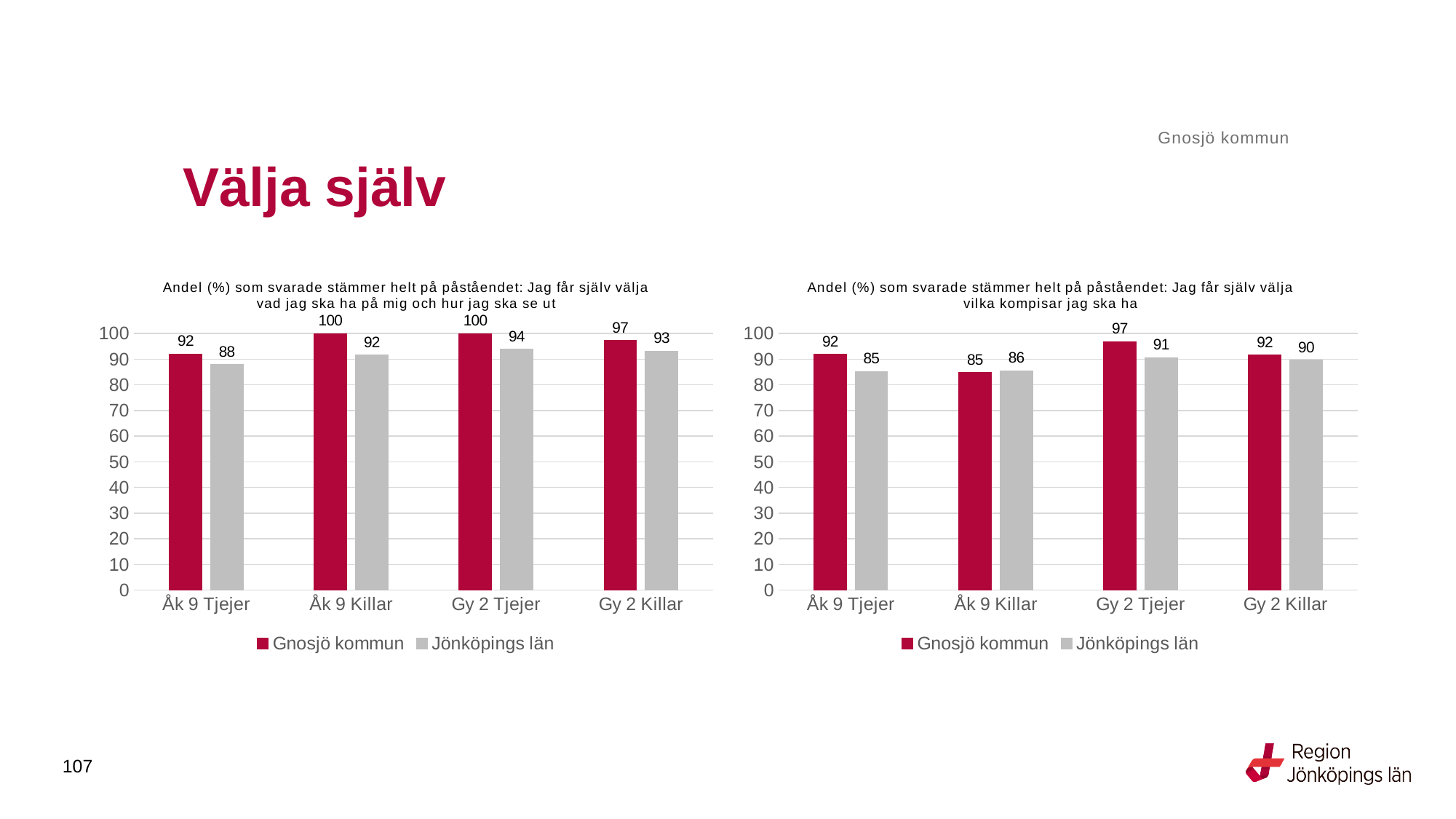
In the left chart (about choosing what to wear and how to look), what is the value for Gnosjö kommun for Åk 9 Tjejer? 92 In the left chart (about choosing what to wear and how to look), which category has the lowest value for Jönköpings län? Åk 9 Tjejer How many series does the legend of the right chart list? 2 In the right chart (about choosing which friends to have), what is the value for Gnosjö kommun for Gy 2 Tjejer? 97 In the left chart (about choosing what to wear and how to look), what is the value for Jönköpings län for Gy 2 Killar? 93 In the left chart (about choosing what to wear and how to look), what is the difference between Gnosjö kommun and Jönköpings län for Åk 9 Killar? 8 In the right chart (about choosing which friends to have), which category has the lowest value for Gnosjö kommun? Åk 9 Killar In the right chart (about choosing which friends to have), what is the difference between Gnosjö kommun and Jönköpings län for Åk 9 Tjejer? 7 What type of chart is the left chart? Bar chart In the right chart (about choosing which friends to have), which is larger for Åk 9 Killar: Gnosjö kommun or Jönköpings län? Jönköpings län How many categories are shown on the x axis of the left chart? 4 In the right chart (about choosing which friends to have), what is the value for Jönköpings län for Åk 9 Tjejer? 85